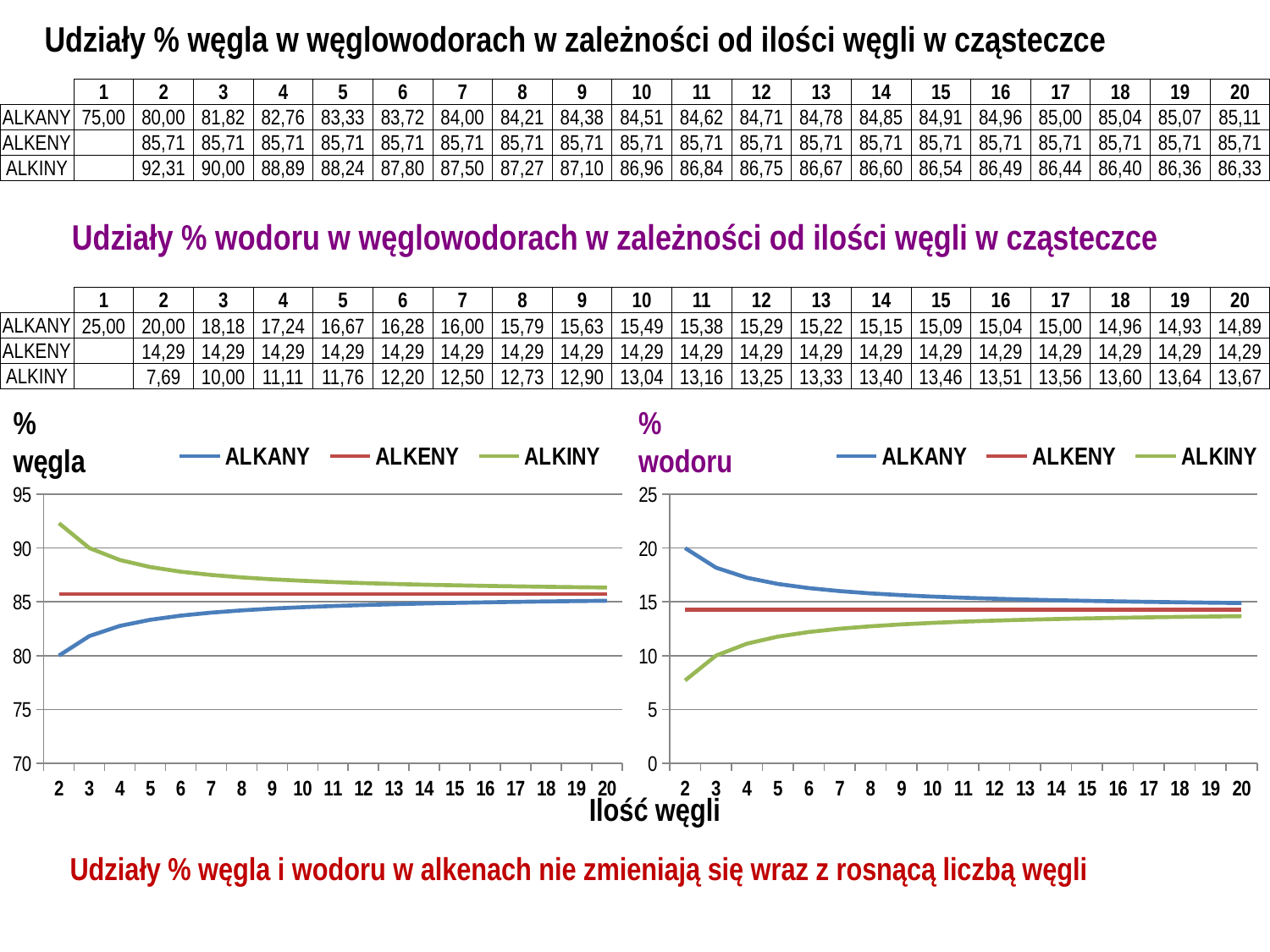
In the right chart (% wodoru), which is larger at Ilość węgli 2: ALKANY or ALKINY? ALKANY In the right chart (% wodoru), is the ALKANY value at Ilość węgli 2 greater or less than 15? greater In the right chart (% wodoru), does the ALKANY line rise or fall as Ilość węgli increases? fall How many series does the legend of the right chart (% wodoru) list? 3 What colour is the ALKENY line in the charts? red In the right chart (% wodoru), does the ALKINY line rise or fall as Ilość węgli increases? rise In the left chart (% węgla), does the ALKINY line rise or fall as Ilość węgli increases? fall How many x-axis points (Ilość węgli values) are shown on the left chart (% węgla)? 19 In the left chart (% węgla), what constant value does the ALKENY line have (as printed in the table above)? 85,71 In the left chart (% węgla), which series has the highest value at Ilość węgli 2? ALKINY In the left chart (% węgla), is the ALKINY value at Ilość węgli 2 greater or less than 90? greater What kind of chart is the left chart (% węgla)? line chart